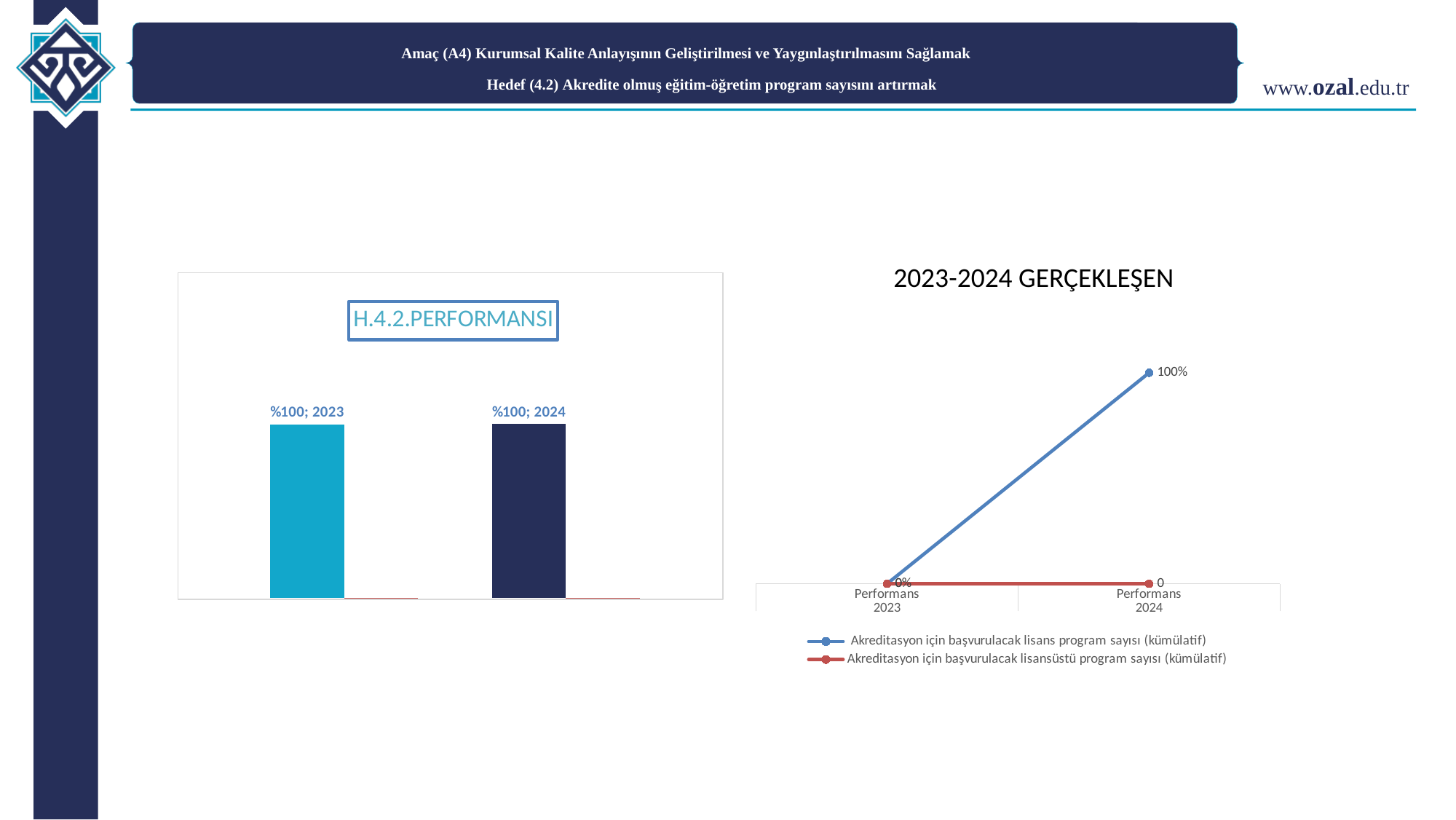
In the 2023-2024 GERÇEKLEŞEN chart, which series has the higher value at Performans 2024? Akreditasyon için başvurulacak lisans program sayısı (kümülatif) In the 2023-2024 GERÇEKLEŞEN chart, what is the value of 'Akreditasyon için başvurulacak lisansüstü program sayısı (kümülatif)' at Performans 2024? 0 What kind of chart is the chart titled 2023-2024 GERÇEKLEŞEN on the right of the slide? line chart What kind of chart is the chart titled H.4.2.PERFORMANSI on the left of the slide? bar chart How many bars are plotted in the H.4.2.PERFORMANSI chart? 4 In the H.4.2.PERFORMANSI chart, what value is shown for 2024? %100 In the 2023-2024 GERÇEKLEŞEN chart, does the 'Akreditasyon için başvurulacak lisans program sayısı (kümülatif)' series rise or fall from Performans 2023 to Performans 2024? rise What is the title of the line chart on the right of the slide? 2023-2024 GERÇEKLEŞEN In the 2023-2024 GERÇEKLEŞEN chart, what is the value of 'Akreditasyon için başvurulacak lisans program sayısı (kümülatif)' at Performans 2024? 100% In the H.4.2.PERFORMANSI chart, what value is shown for 2023? %100 How many series does the legend of the 2023-2024 GERÇEKLEŞEN chart list? 2 In the 2023-2024 GERÇEKLEŞEN chart, what is the value of 'Akreditasyon için başvurulacak lisans program sayısı (kümülatif)' at Performans 2023? 0%